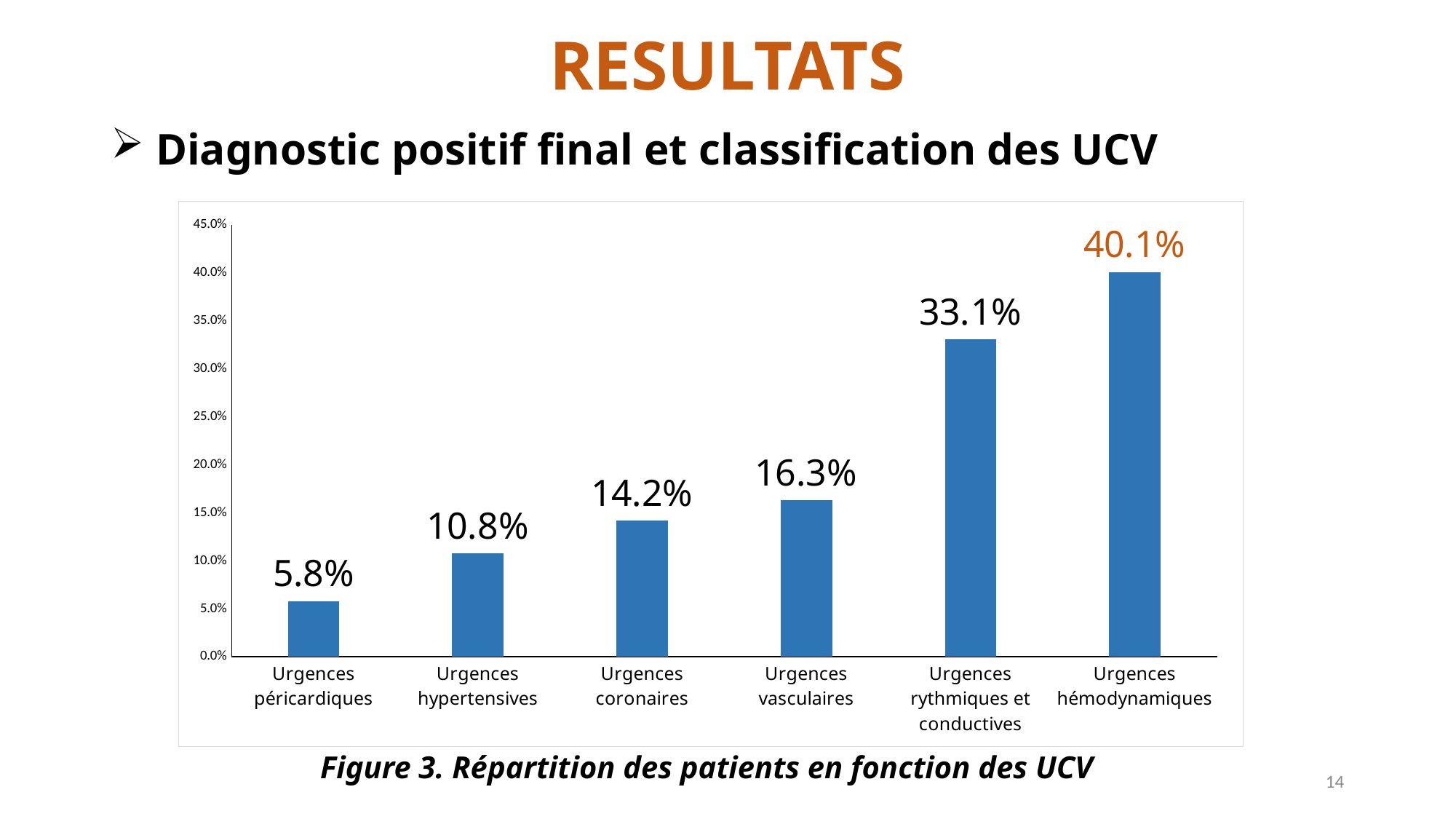
What is the value for Urgences rythmiques et conductives? 33.1% What is the value for Urgences hémodynamiques? 40.1% Which category has the highest value? Urgences hémodynamiques Which is larger, the value for Urgences vasculaires or the value for Urgences hypertensives? Urgences vasculaires What is the value for Urgences péricardiques? 5.8% Is the value for Urgences vasculaires greater or less than 20.0%? less Which category has the lowest value? Urgences péricardiques What is the difference between the values for Urgences hémodynamiques and Urgences rythmiques et conductives? 7.0% What kind of chart is shown on the slide? bar chart What is the value for Urgences coronaires? 14.2% What is the figure caption below the chart? Figure 3. Répartition des patients en fonction des UCV How many categories are shown on the x axis? 6